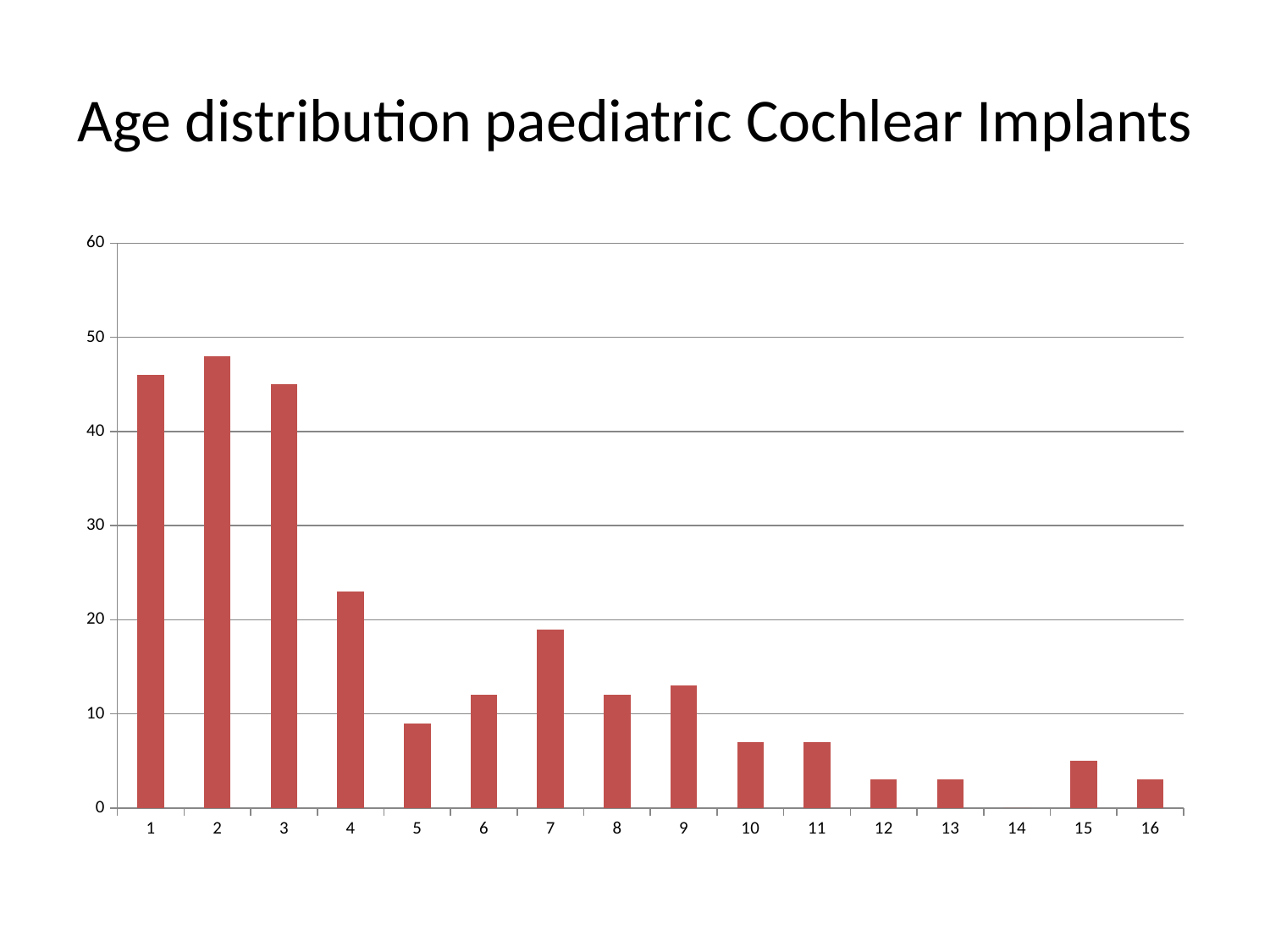
Is the value for category 4 greater or less than 20? greater Which category has the lowest value (no visible bar)? 14 Is the value for category 1 greater or less than 40? greater Is the value for category 5 greater or less than 10? less What is the title of the chart? Age distribution paediatric Cochlear Implants Do the values generally rise or fall as the category number increases from 1 to 16? fall Which category has the tallest bar? 2 What kind of chart is shown on the slide? bar chart Which is larger, the value for category 4 or category 7? 4 How many categories are shown on the x axis? 16 Which is larger, the value for category 12 or category 15? 15